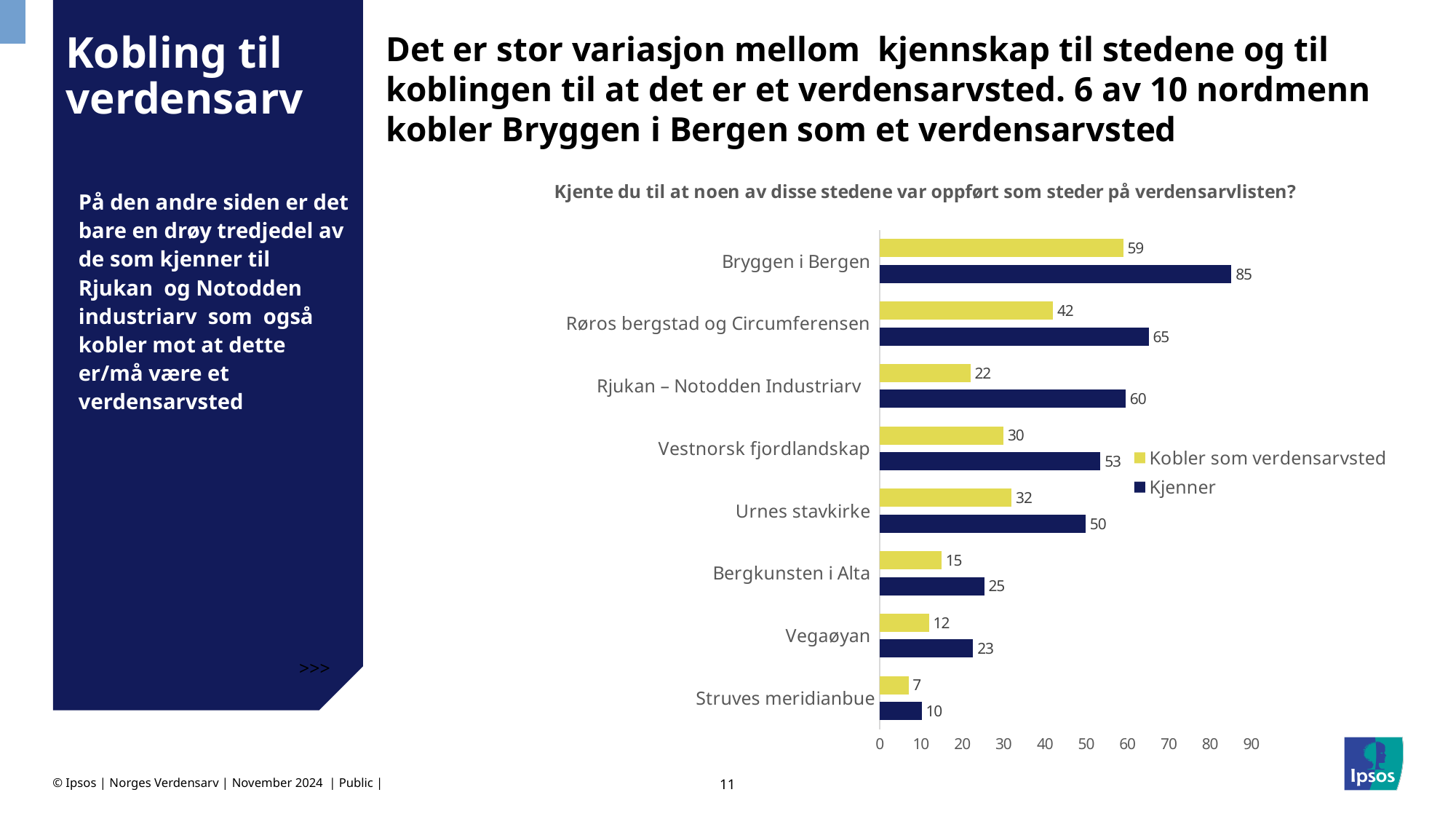
What is the 'Kjenner' value for Vegaøyan? 23 Which is larger: the 'Kobler som verdensarvsted' value for Urnes stavkirke or for Vestnorsk fjordlandskap? Urnes stavkirke How many sites are shown on the chart? 8 Which site has the highest 'Kobler som verdensarvsted' value? Bryggen i Bergen What is the 'Kjenner' value for Bryggen i Bergen? 85 What kind of chart is shown on the slide? Bar chart Which site has the lowest 'Kjenner' value? Struves meridianbue How many series does the legend list? 2 What is the 'Kjenner' value for Urnes stavkirke? 50 What is the difference between the 'Kjenner' and 'Kobler som verdensarvsted' values for Rjukan – Notodden Industriarv? 38 What is the 'Kobler som verdensarvsted' value for Rjukan – Notodden Industriarv? 22 Which series is shown in dark blue in the legend? Kjenner